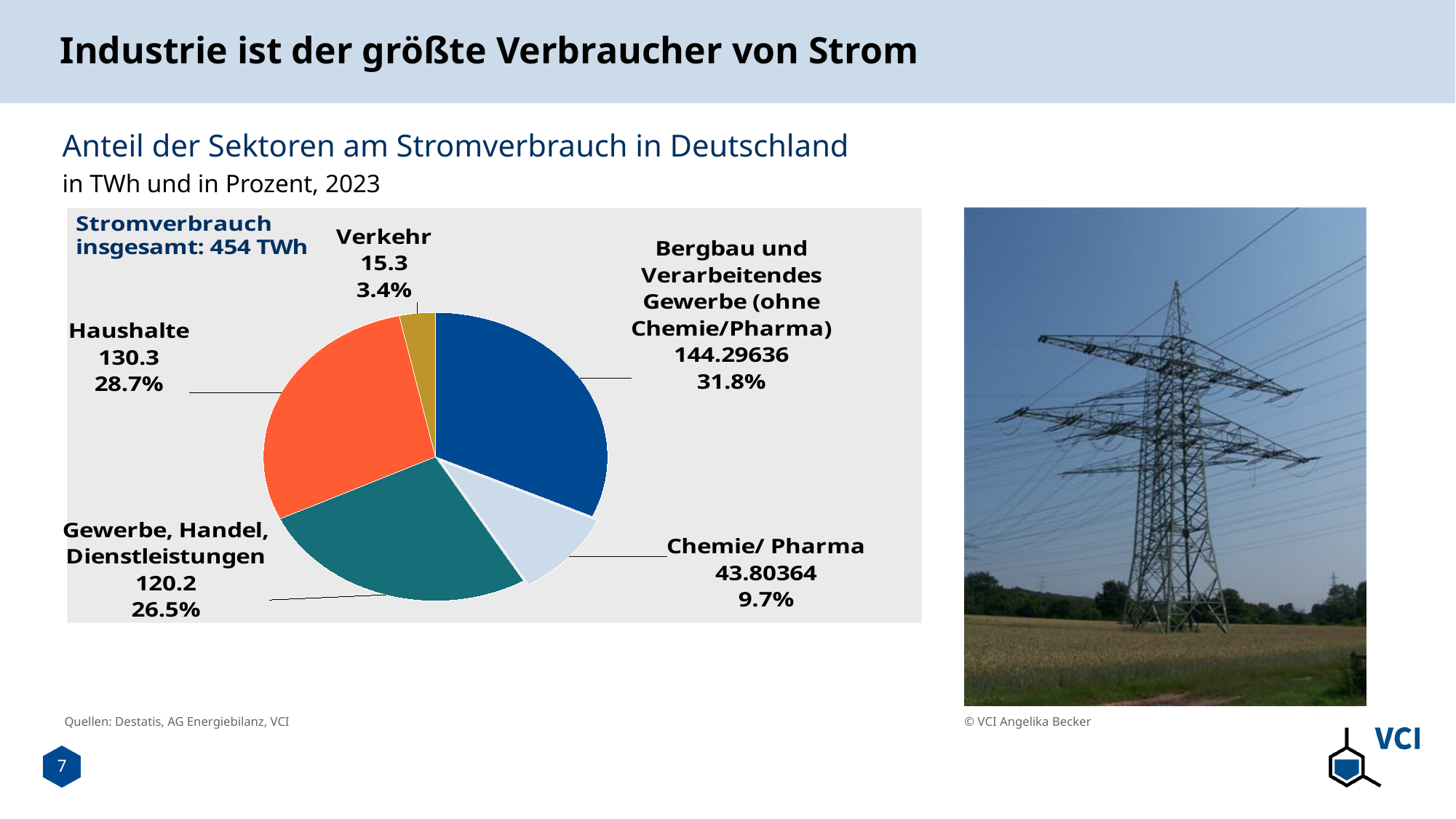
What kind of chart is shown on the slide? Pie chart Which is larger, the value for Haushalte or the value for Gewerbe, Handel, Dienstleistungen? Haushalte What colour is the slice for Haushalte? Orange Which sector has the smallest share of electricity consumption? Verkehr What is the difference in TWh between Haushalte and Gewerbe, Handel, Dienstleistungen? 10.1 Which sector has the largest share of electricity consumption? Bergbau und Verarbeitendes Gewerbe (ohne Chemie/Pharma) What percentage share does Verkehr have? 3.4% What is the value in TWh for Haushalte? 130.3 What is the total electricity consumption stated on the chart? 454 TWh What is the value in TWh for Chemie/ Pharma? 43.80364 What percentage share does Bergbau und Verarbeitendes Gewerbe (ohne Chemie/Pharma) have? 31.8% How many sectors (slices) does the pie chart show? 5